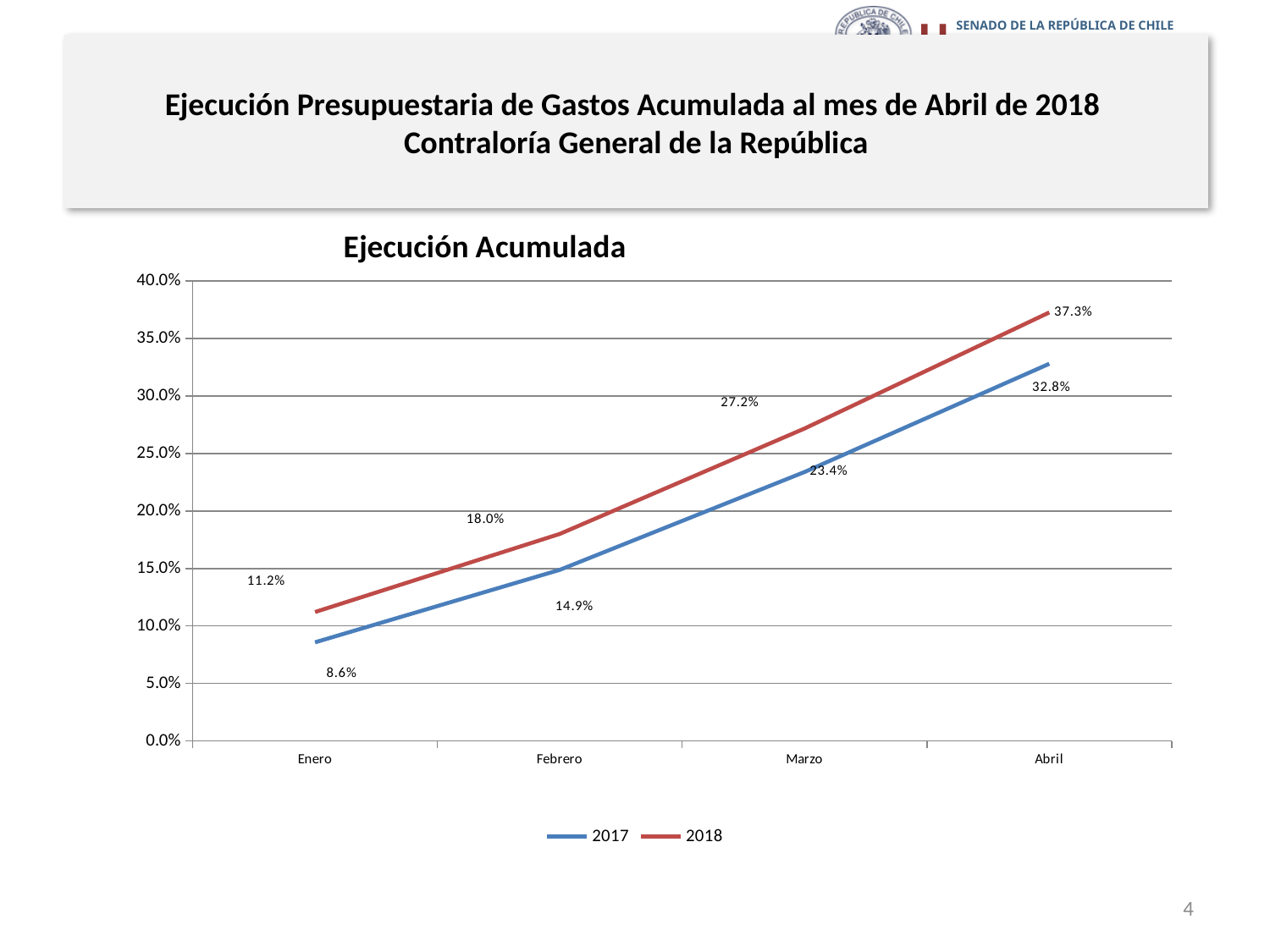
What is the value for 2017 in Enero? 8.6% How many months are shown on the x axis? 4 In which month is the 2018 series highest? Abril Which series has the larger value in Marzo, 2017 or 2018? 2018 How many series does the legend list? 2 What is the value for 2017 in Marzo? 23.4% What is the value for 2018 in Febrero? 18.0% What is the difference between the 2018 and 2017 values in Abril? 4.5% What is the value for 2018 in Abril? 37.3% Do the values for 2017 rise or fall from Enero to Abril? Rise What kind of chart is shown? Line chart In which month is the 2017 series lowest? Enero